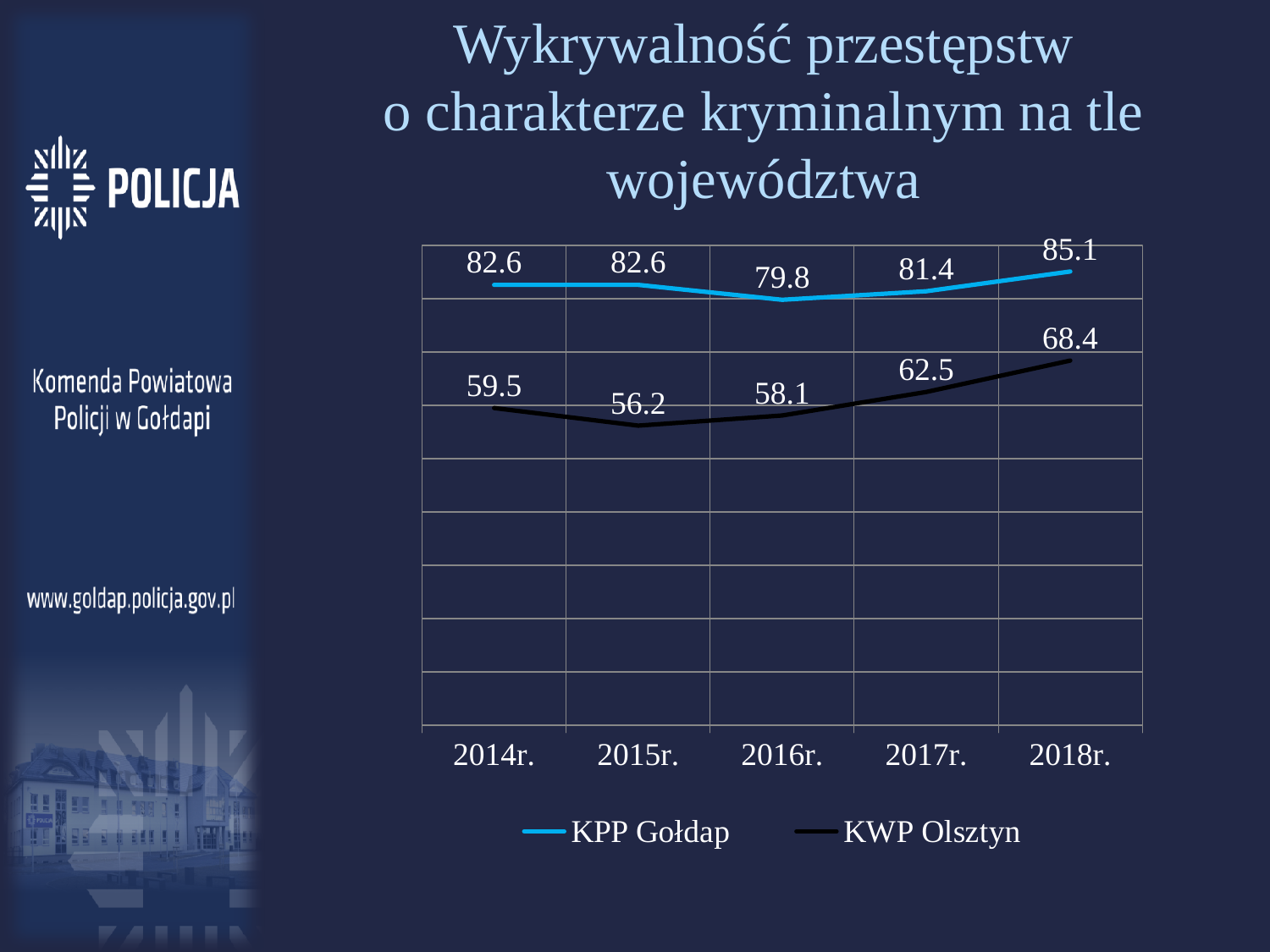
How many series does the legend list? 2 What is the value for KWP Olsztyn in 2015r.? 56.2 Does the KWP Olsztyn value rise or fall from 2015r. to 2018r.? Rise What kind of chart is shown on the slide? Line chart What is the value for KPP Gołdap in 2018r.? 85.1 Which series has the larger value in 2017r., KPP Gołdap or KWP Olsztyn? KPP Gołdap In which year is the KPP Gołdap value lowest? 2016r. What colour is the line for KPP Gołdap? Blue What is the value for KPP Gołdap in 2016r.? 79.8 What is the difference between KPP Gołdap and KWP Olsztyn in 2014r.? 23.1 In which year is the KWP Olsztyn value highest? 2018r. How many years are shown on the x axis? 5